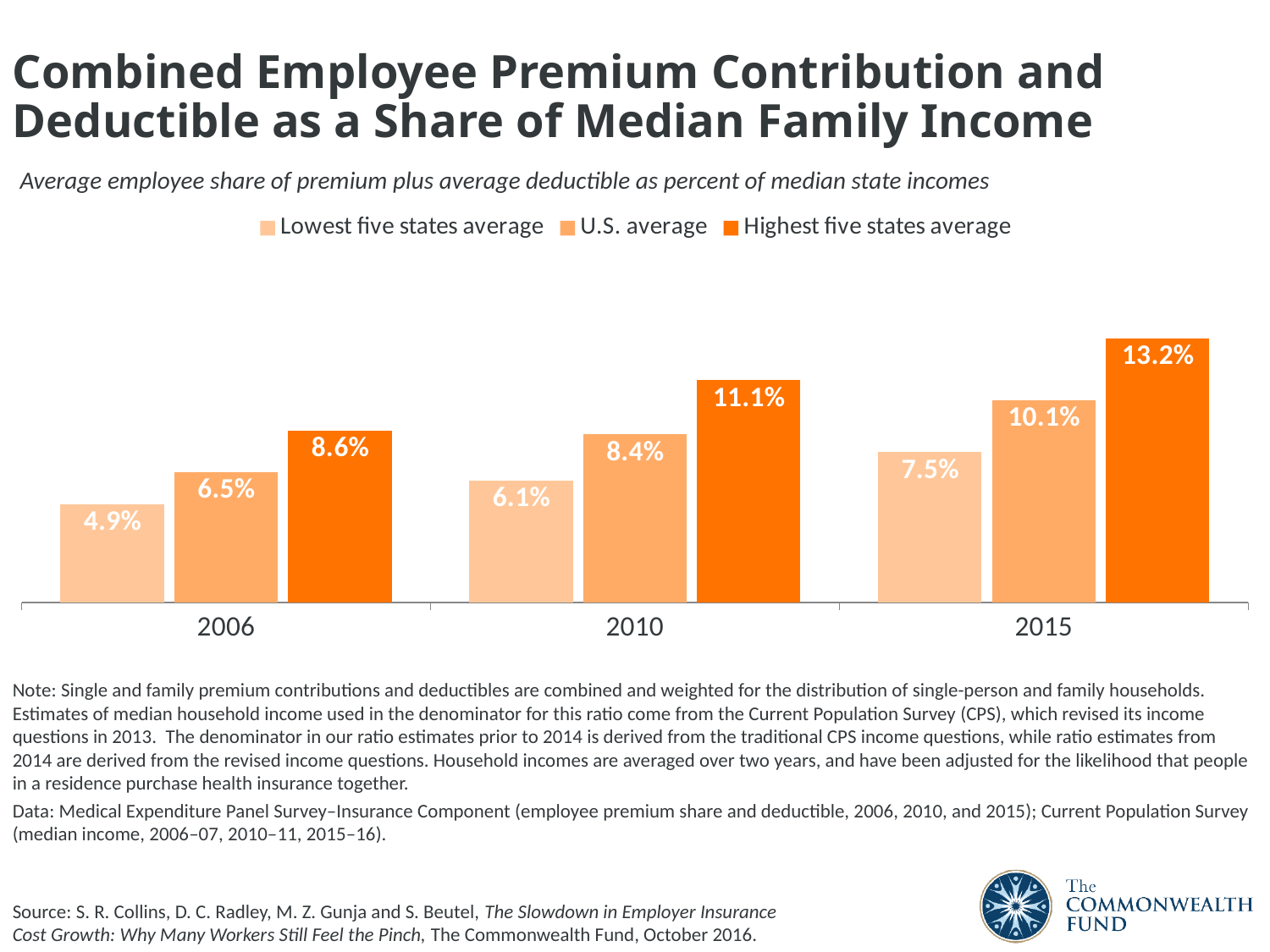
Which year has the highest Highest five states average value? 2015 What kind of chart is shown on the slide? Bar chart What is the difference between the Highest five states average and the Lowest five states average in 2015? 5.7% Does the U.S. average rise or fall from 2006 to 2015? Rise Which year has the lowest Lowest five states average value? 2006 Which series is shown in the darkest orange colour? Highest five states average Which is larger: the U.S. average in 2006 or the Lowest five states average in 2015? Lowest five states average in 2015 How many years are shown on the x axis? 3 What is the U.S. average value for 2010? 8.4% How many series does the legend list? 3 What is the Highest five states average value for 2015? 13.2% What is the Lowest five states average value for 2006? 4.9%